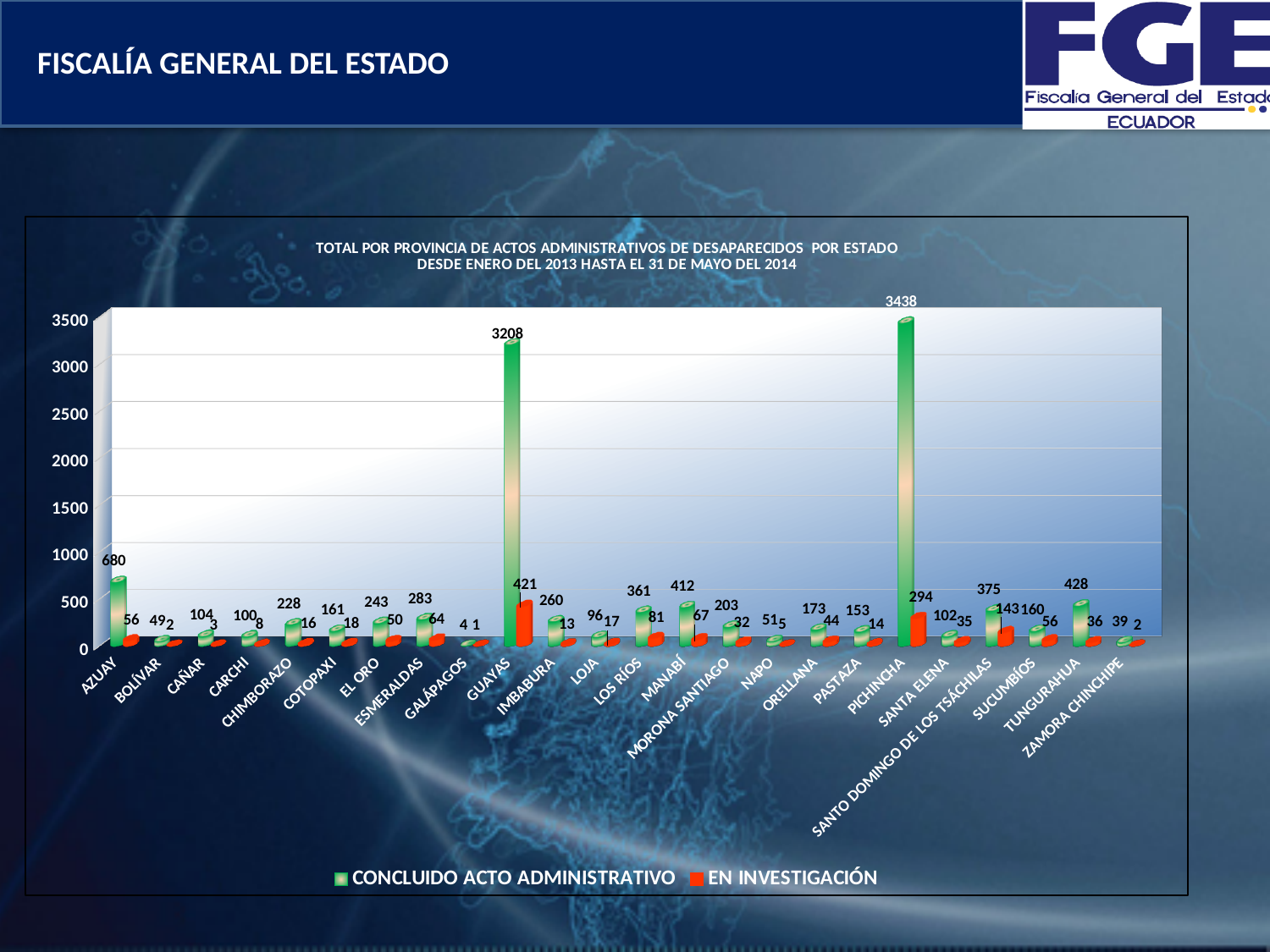
Which is larger, the CONCLUIDO ACTO ADMINISTRATIVO value for TUNGURAHUA or for MANABÍ? TUNGURAHUA Is the CONCLUIDO ACTO ADMINISTRATIVO value for GUAYAS greater or less than 3000? greater How many series does the legend list? 2 What is the CONCLUIDO ACTO ADMINISTRATIVO value for AZUAY? 680 What is the CONCLUIDO ACTO ADMINISTRATIVO value for PICHINCHA? 3438 What is the difference between the CONCLUIDO ACTO ADMINISTRATIVO values for PICHINCHA and GUAYAS? 230 Which province has the highest CONCLUIDO ACTO ADMINISTRATIVO value? PICHINCHA Which province has the lowest CONCLUIDO ACTO ADMINISTRATIVO value? GALÁPAGOS What is the EN INVESTIGACIÓN value for SANTO DOMINGO DE LOS TSÁCHILAS? 143 How many provinces are shown on the x axis? 24 What kind of chart is shown on the slide? Bar chart What is the EN INVESTIGACIÓN value for GUAYAS? 421